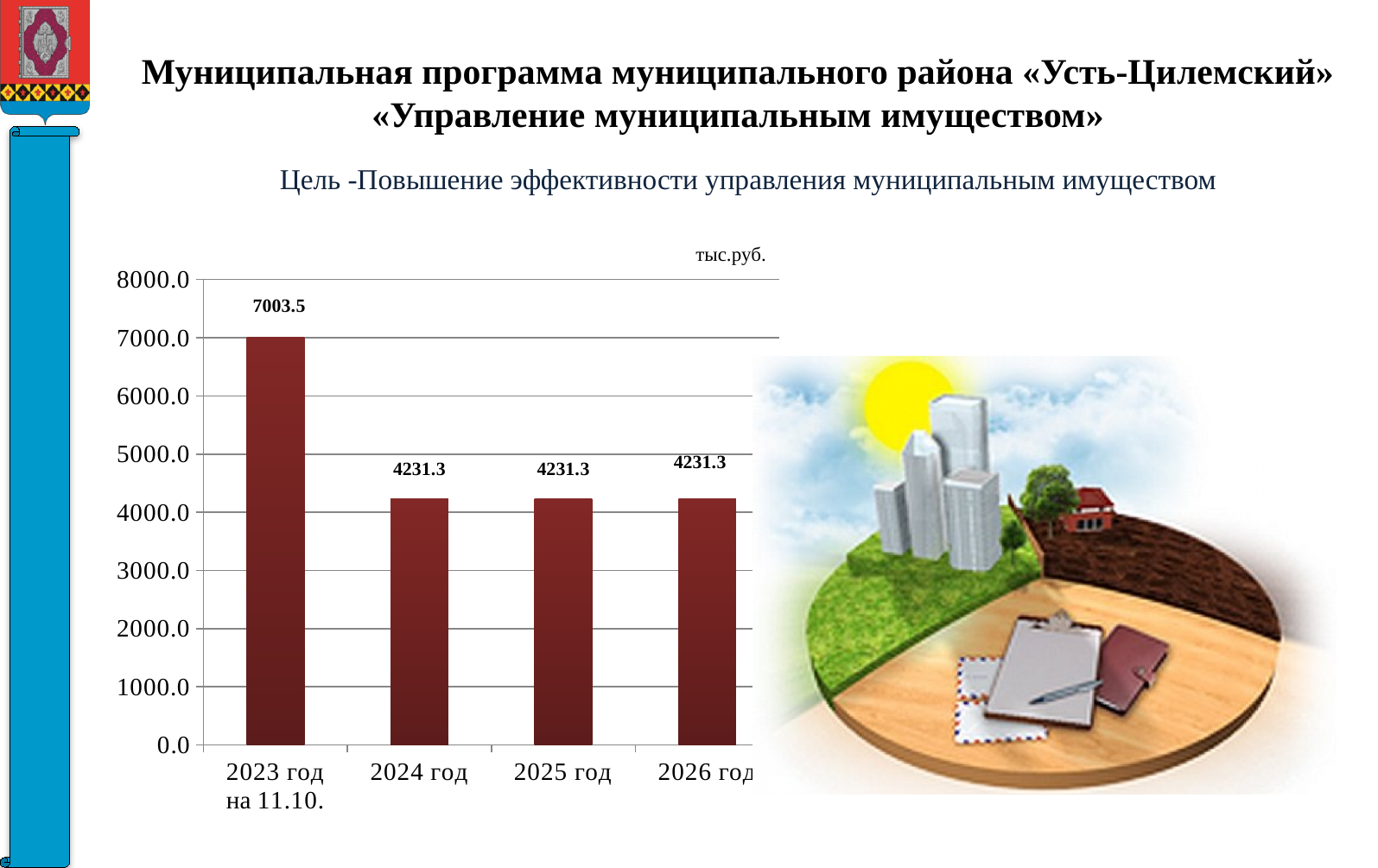
Which is larger, the value for 2023 год на 11.10. or the value for 2025 год? 2023 год на 11.10. What kind of chart is shown on the slide? bar chart Which category has the highest value? 2023 год на 11.10. Do the values rise or fall from 2023 год на 11.10. to 2024 год? fall What is the value for 2026 год? 4231.3 How many categories are shown on the x axis? 4 Is the value for 2025 год greater or less than 5000.0? less What is the difference between the values for 2023 год на 11.10. and 2024 год? 2772.2 What unit is shown above the chart? тыс.руб. What is the value for 2023 год на 11.10.? 7003.5 What is the value for 2024 год? 4231.3 Is the value for 2023 год на 11.10. greater or less than 6000.0? greater